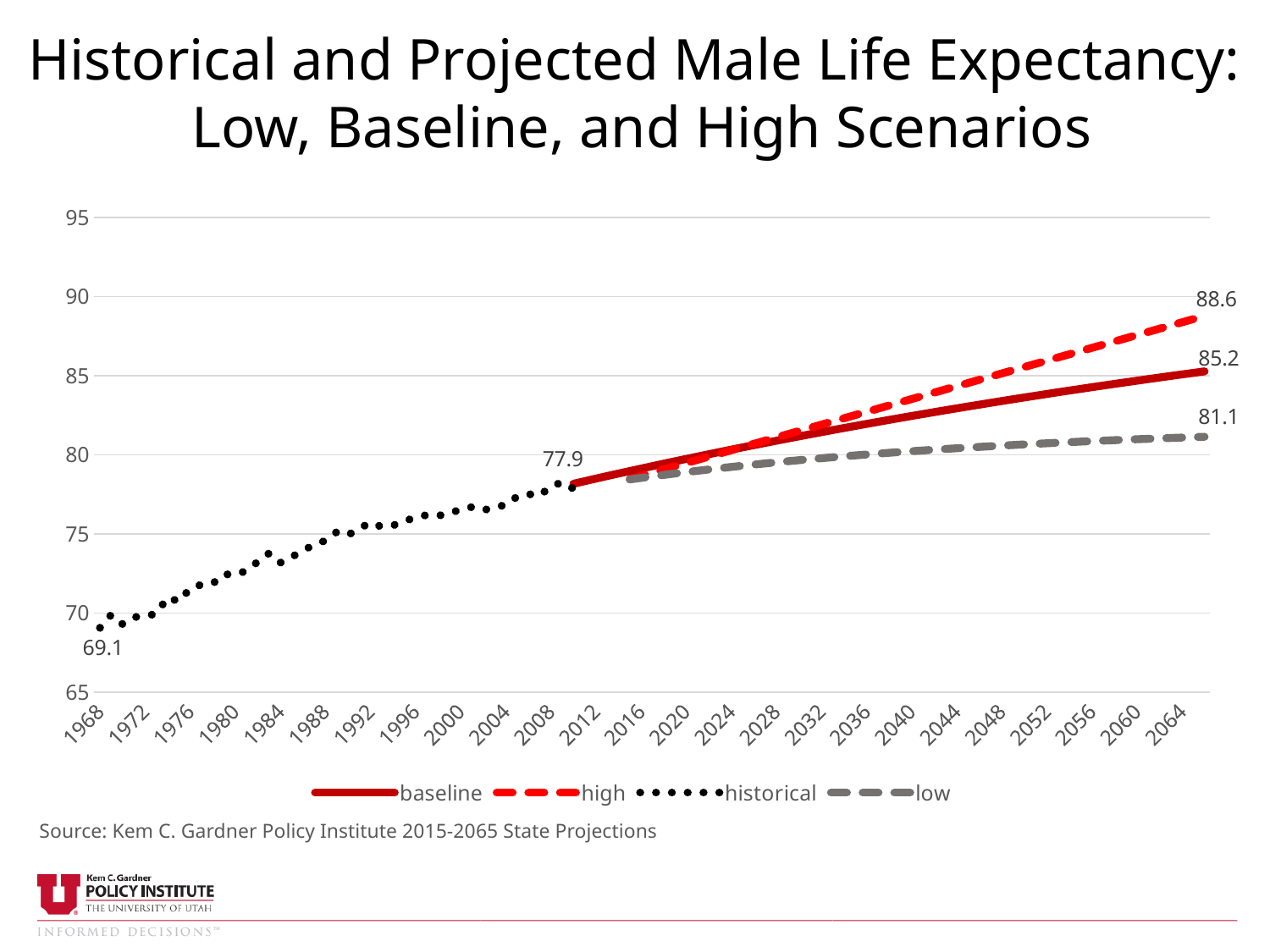
Which scenario ends with the highest projected male life expectancy? high What is the first labeled value of the historical series? 69.1 How many series does the legend list? 4 What is the final projected value of the high scenario? 88.6 What is the difference between the final high scenario value and the final low scenario value? 7.5 What is the final projected value of the low scenario? 81.1 What is the last labeled value of the historical series? 77.9 Is the low scenario's value in 2040 greater or less than 85? less What type of chart is shown on the slide? line chart Does the historical series rise or fall from 1968 onward? rise What is the final projected value of the baseline scenario? 85.2 Which scenario ends with the lowest projected male life expectancy? low